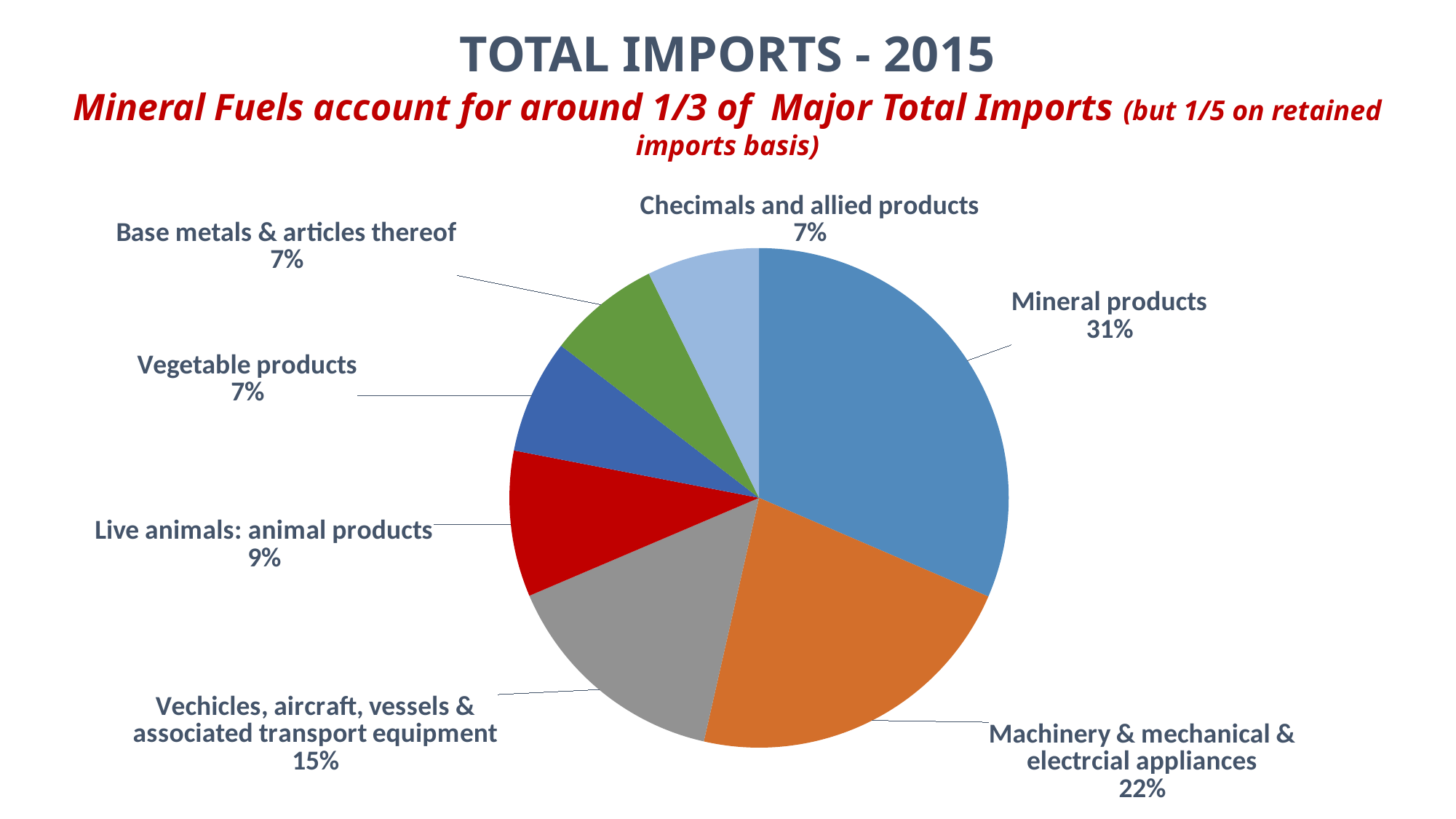
What is the combined share of Mineral products and Machinery & mechanical & electrcial appliances? 53% What colour is the slice for Live animals: animal products? Red What share of total imports is Vechicles, aircraft, vessels & associated transport equipment? 15% What share of total imports is Machinery & mechanical & electrcial appliances? 22% What share of total imports do Mineral products account for? 31% Which has a larger share: Live animals: animal products or Vegetable products? Live animals: animal products What is the difference in share between Mineral products and Machinery & mechanical & electrcial appliances? 9% How many categories are shown in the pie chart? 7 What is the title of the chart? TOTAL IMPORTS - 2015 What kind of chart is shown on the slide? Pie chart Which category has the largest share of total imports? Mineral products What share of total imports is Live animals: animal products? 9%